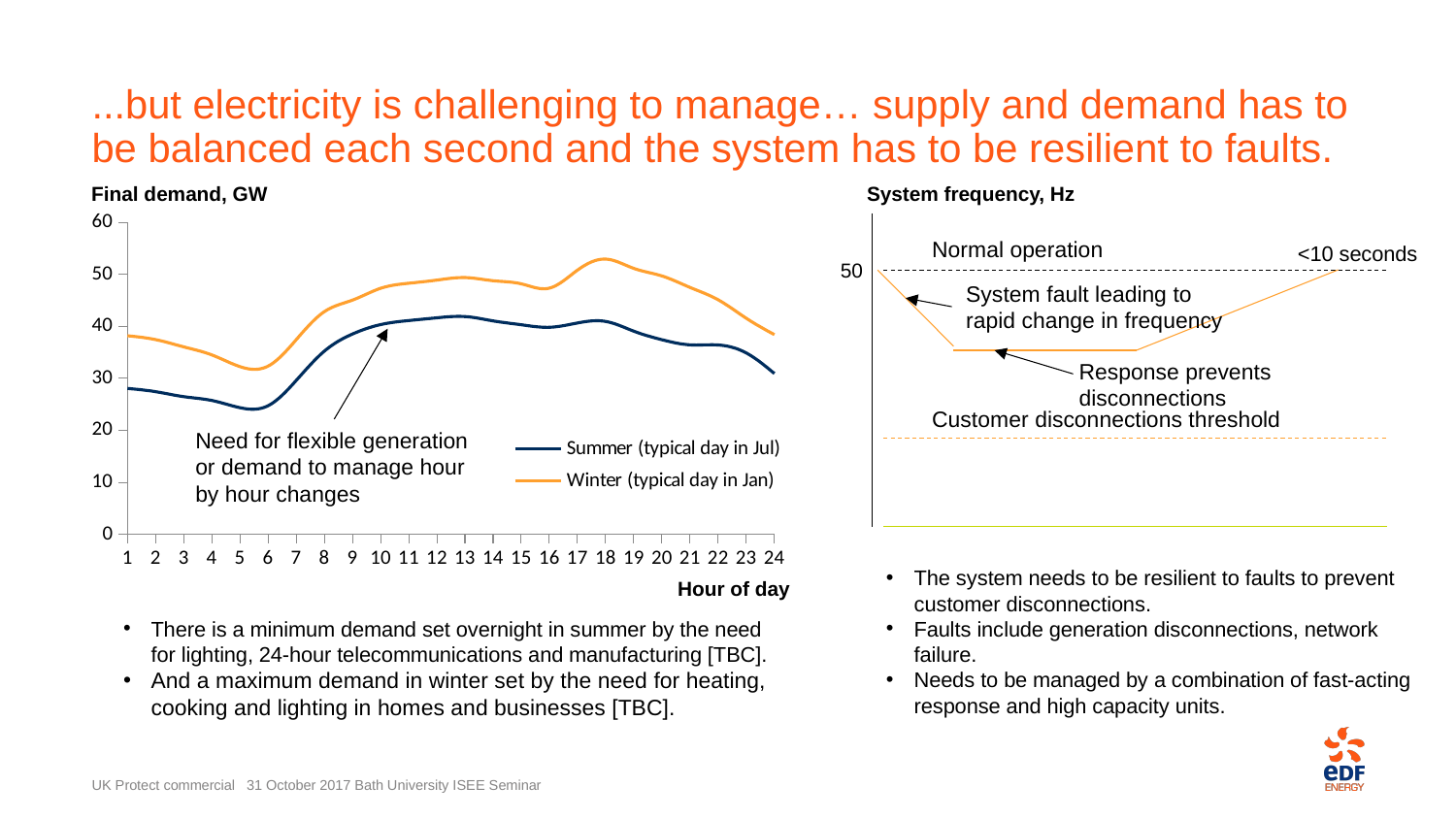
In the 'Final demand, GW' chart, is the Summer (typical day in Jul) value at hour 6 greater or less than 30? less In the 'Final demand, GW' chart, is the Winter (typical day in Jan) value at hour 6 greater or less than 40? less How many series does the legend of the 'Final demand, GW' chart list? 2 How many hours of the day are plotted along the x axis of the 'Final demand, GW' chart? 24 In the 'Final demand, GW' chart, is the Winter (typical day in Jan) value at hour 18 greater or less than 50? greater In the 'Final demand, GW' chart, does the Summer (typical day in Jul) line rise or fall between hour 6 and hour 13? rise In the 'Final demand, GW' chart, which series has the highest value overall? Winter (typical day in Jan) What is the x-axis label of the 'Final demand, GW' chart? Hour of day What kind of chart is the 'Final demand, GW' chart? Line chart In the 'Final demand, GW' chart, which series is higher at hour 18, Summer (typical day in Jul) or Winter (typical day in Jan)? Winter (typical day in Jan) In the 'Final demand, GW' chart, does the Winter (typical day in Jan) line rise or fall between hour 18 and hour 24? fall